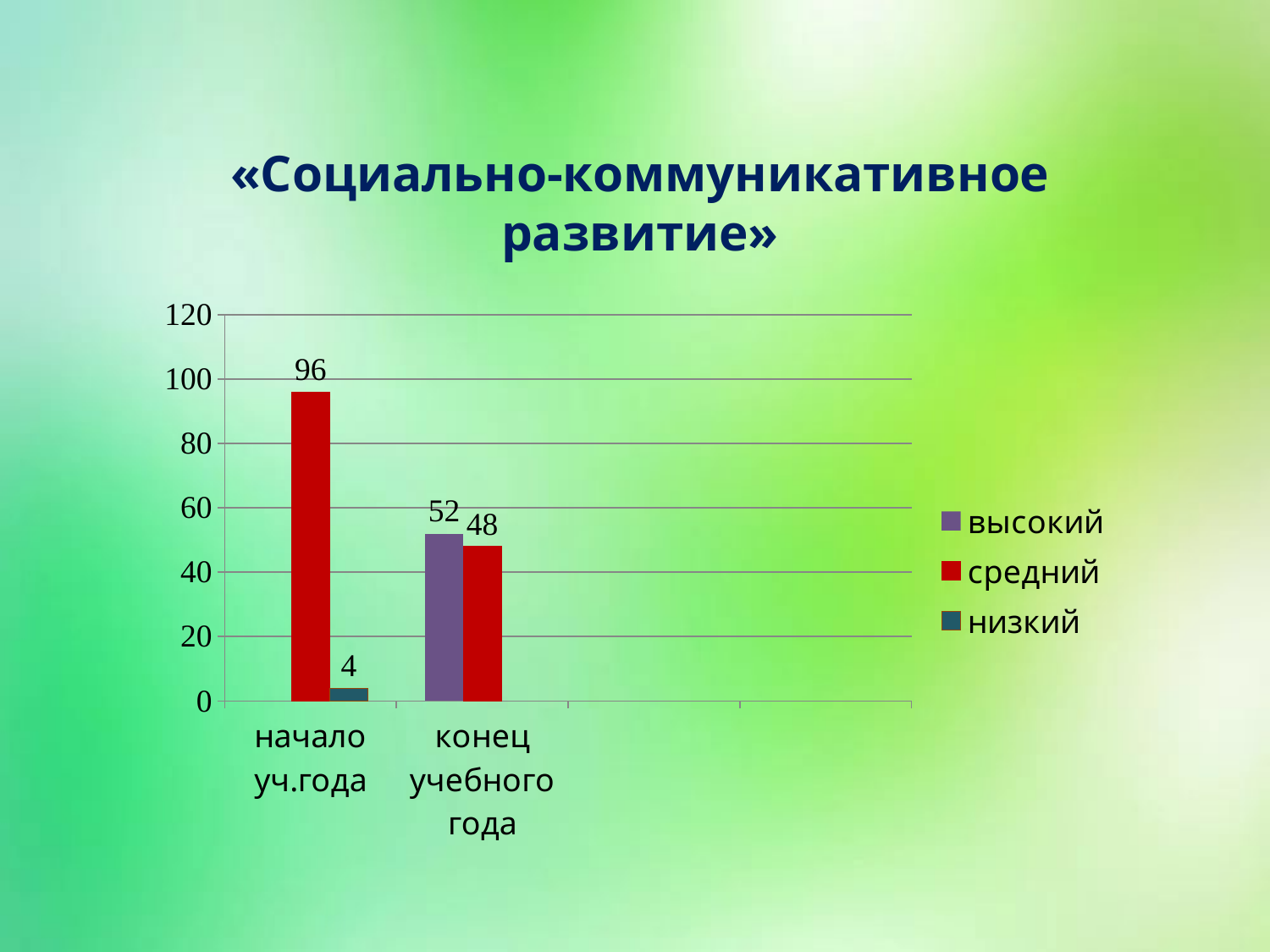
What is the value for средний at конец учебного года? 48 What kind of chart is shown on the slide? bar chart Which series has the highest value at начало уч.года? средний Does the средний value rise or fall from начало уч.года to конец учебного года? fall What is the difference between высокий and средний at конец учебного года? 4 What is the difference between the средний values at начало уч.года and конец учебного года? 48 How many series does the legend list? 3 What is the value for средний at начало уч.года? 96 Which series has the highest value at конец учебного года? высокий What is the value for низкий at начало уч.года? 4 Which is larger: средний at начало уч.года or высокий at конец учебного года? средний at начало уч.года What is the value for высокий at конец учебного года? 52